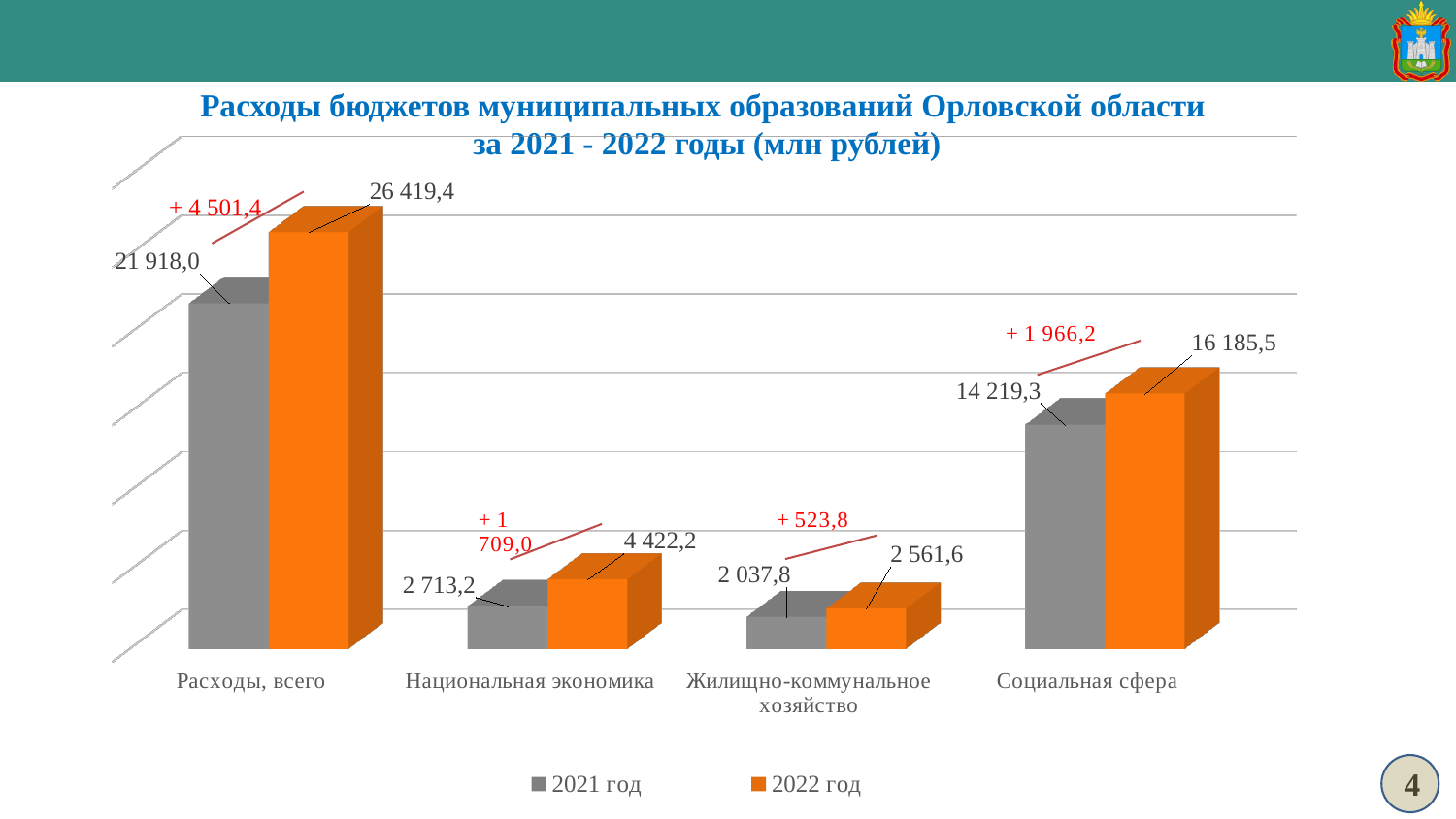
Which category has the highest value for 2021 год? Расходы, всего How many categories are shown on the x axis? 4 What is the difference between the 2022 год and 2021 год values for Социальная сфера? 1 966,2 Which category has the lowest value for 2022 год? Жилищно-коммунальное хозяйство What is the value for 2021 год in the category Жилищно-коммунальное хозяйство? 2 037,8 How many series does the legend list? 2 What is the value for 2022 год in the category Национальная экономика? 4 422,2 What is the value for 2021 год in the category Расходы, всего? 21 918,0 Which is larger: the 2021 год value for Социальная сфера or the 2022 год value for Национальная экономика? 2021 год value for Социальная сфера What is the difference between the 2022 год and 2021 год values for Национальная экономика? 1 709,0 What kind of chart is shown on the slide? Bar chart What is the value for 2022 год in the category Социальная сфера? 16 185,5